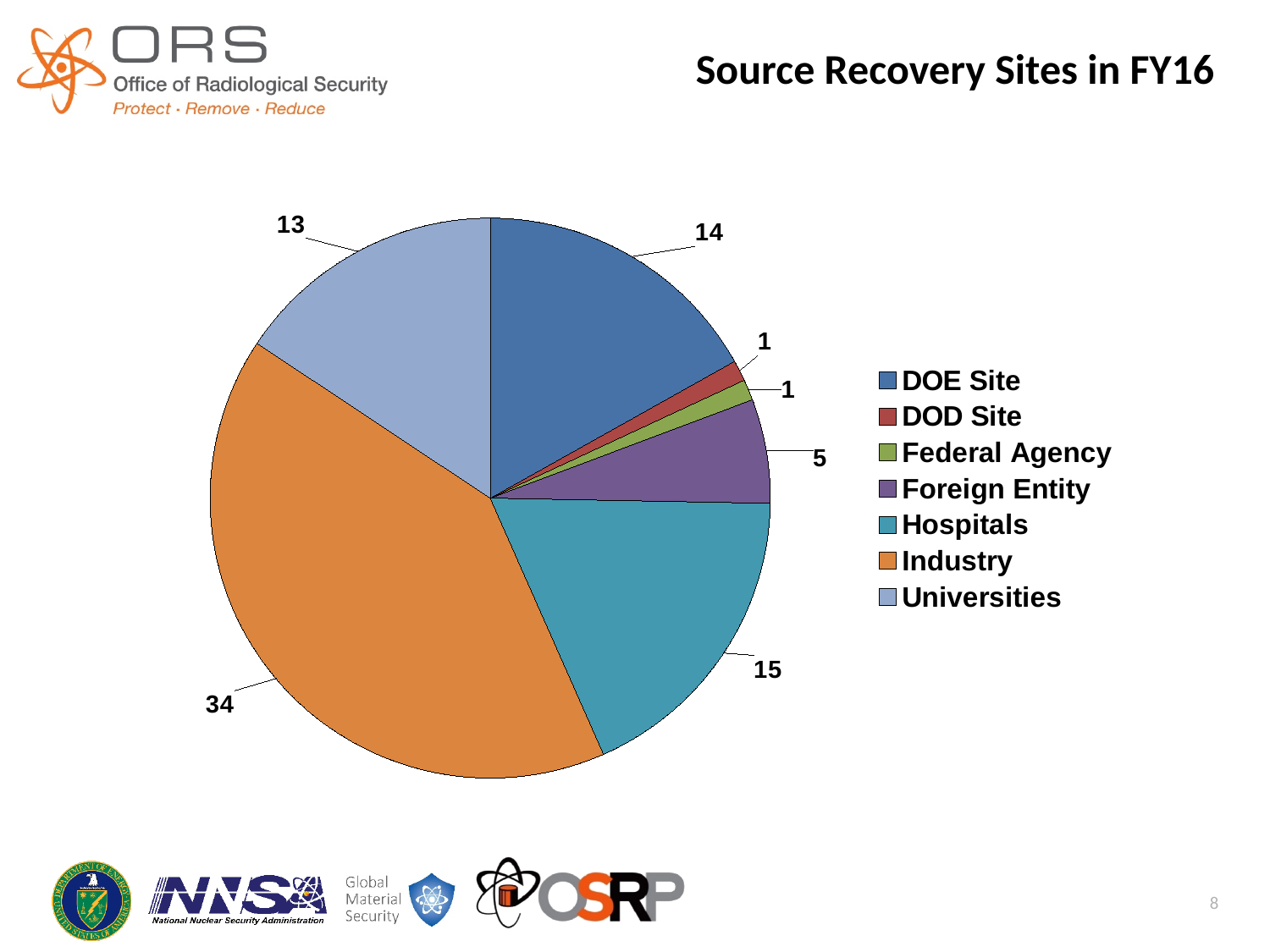
What is the title of the chart? Source Recovery Sites in FY16 What is the value for Universities? 13 Which is larger, the value for Hospitals or the value for DOE Site? Hospitals What is the value for Industry? 34 What is the value for Hospitals? 15 How many categories does the legend list? 7 What type of chart is shown on the slide? pie chart What is the difference between the values for Industry and Hospitals? 19 What is the value for Foreign Entity? 5 What is the total of all the slices in the pie? 83 What is the value for DOE Site? 14 Which category has the largest slice? Industry